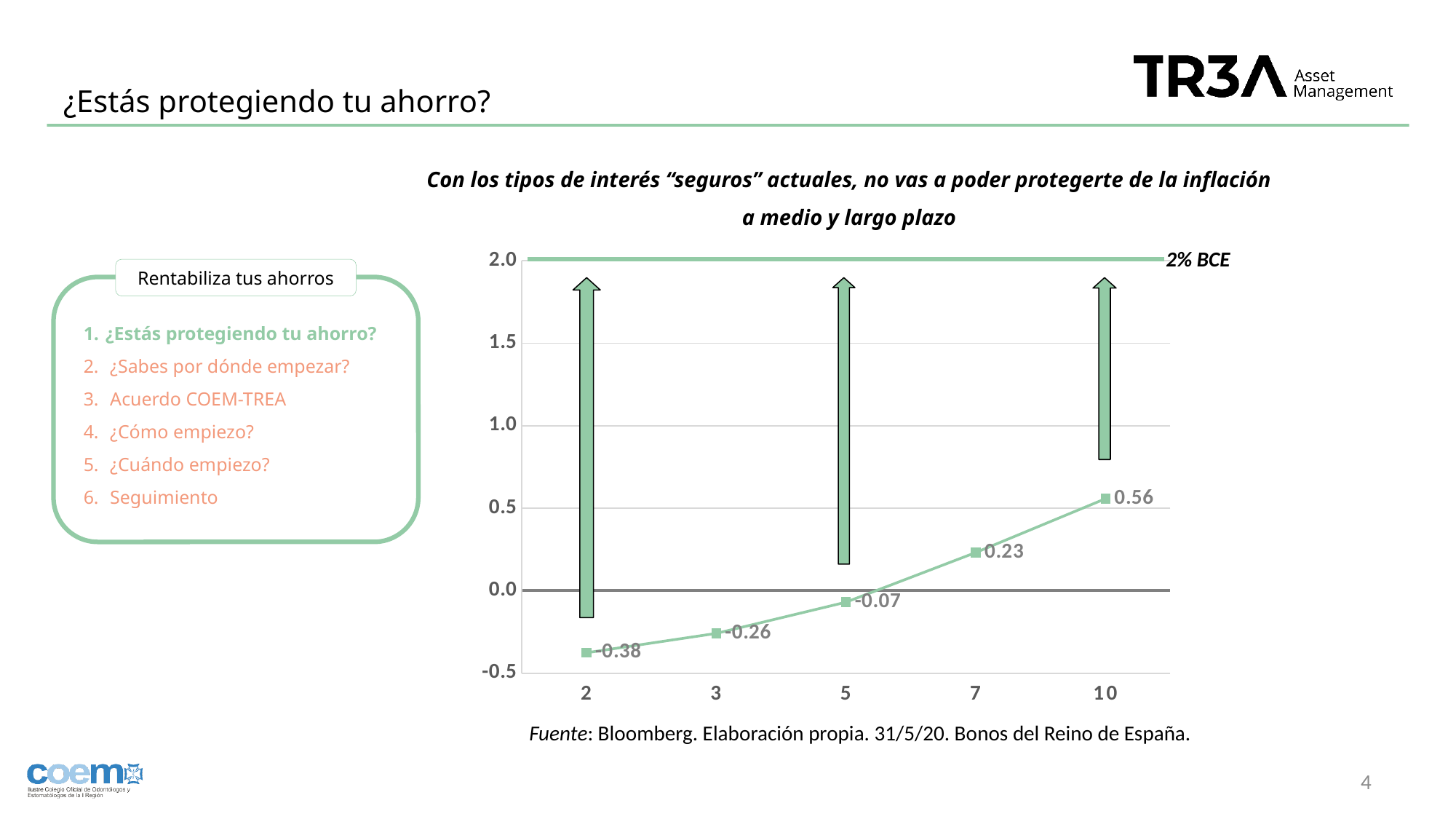
Is the value at x = 7 greater or less than 0.5? less How many data points are plotted on the line? 5 Do the values rise or fall along the x axis? rise What is the difference between the values at x = 10 and x = 7? 0.33 What is the value plotted at x = 2? -0.38 What label is shown next to the horizontal line at 2.0? 2% BCE What is the value plotted at x = 5? -0.07 Which x-axis category has the lowest value? 2 Which is larger, the value at x = 3 or the value at x = 5? 5 What is the value plotted at x = 10? 0.56 Which x-axis category has the highest value? 10 What kind of chart is shown? line chart